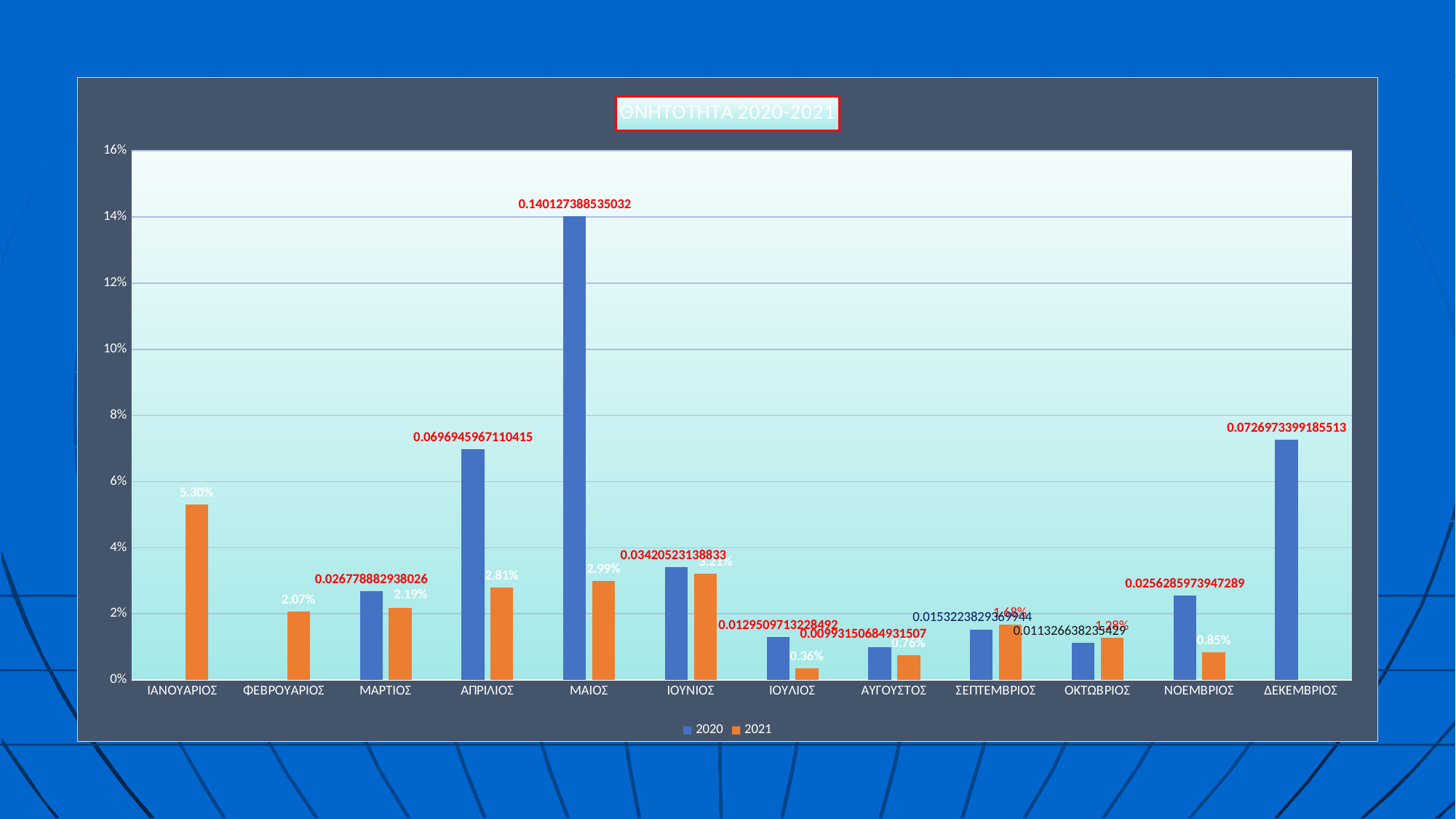
What is the 2021 value for ΙΟΥΝΙΟΣ? 3.21% Which month has the highest 2020 value? ΜΑΙΟΣ What is the title of the chart? ΘΝΗΤΟΤΗΤΑ 2020-2021 What is the 2021 value for ΙΑΝΟΥΑΡΙΟΣ? 5.30% Which month has the lowest 2021 value? ΙΟΥΛΙΟΣ What is the 2020 value labelled for ΔΕΚΕΜΒΡΙΟΣ? 0.0726973399185513 How many series does the legend list? 2 Is the 2020 value for ΑΠΡΙΛΙΟΣ greater or less than 6%? greater What is the 2020 value labelled for ΜΑΙΟΣ? 0.140127388535032 Which is larger for ΝΟΕΜΒΡΙΟΣ, the 2020 value or the 2021 value? 2020 How many months are shown on the x axis? 12 What type of chart is shown on the slide? bar chart